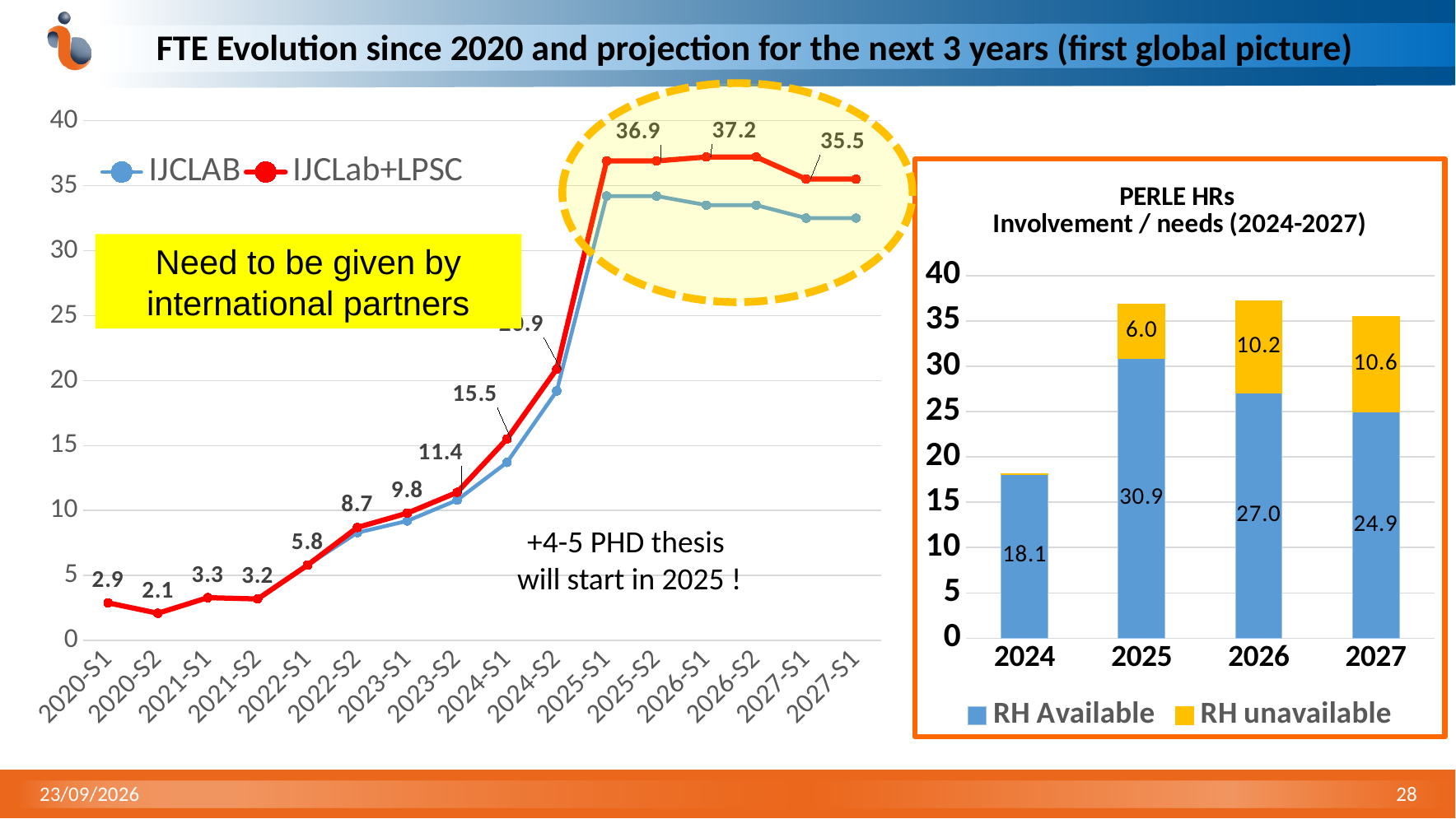
How many years are shown on the x axis of the PERLE HRs chart? 4 In the PERLE HRs chart, which year has the lowest RH Available value? 2024 What kind of chart is the PERLE HRs chart on the right of the slide? bar chart In the PERLE HRs chart, what is the total of the stacked bar for 2027? 35.5 In the left FTE Evolution chart, is the IJCLAB value at 2025-S1 greater or less than 30? greater In the PERLE HRs chart, what is the RH unavailable value for 2026? 10.2 In the PERLE HRs chart, what is the RH Available value for 2025? 30.9 In the PERLE HRs chart, which year has the highest RH Available value? 2025 How many series does the legend of the left FTE Evolution line chart list? 2 In the PERLE HRs chart, what is the difference between the RH unavailable values for 2027 and 2025? 4.6 In the left FTE Evolution chart, what is the IJCLab+LPSC value at 2024-S1? 15.5 In the left FTE Evolution chart, which is larger for IJCLab+LPSC: the value at 2022-S2 or at 2023-S1? 2023-S1